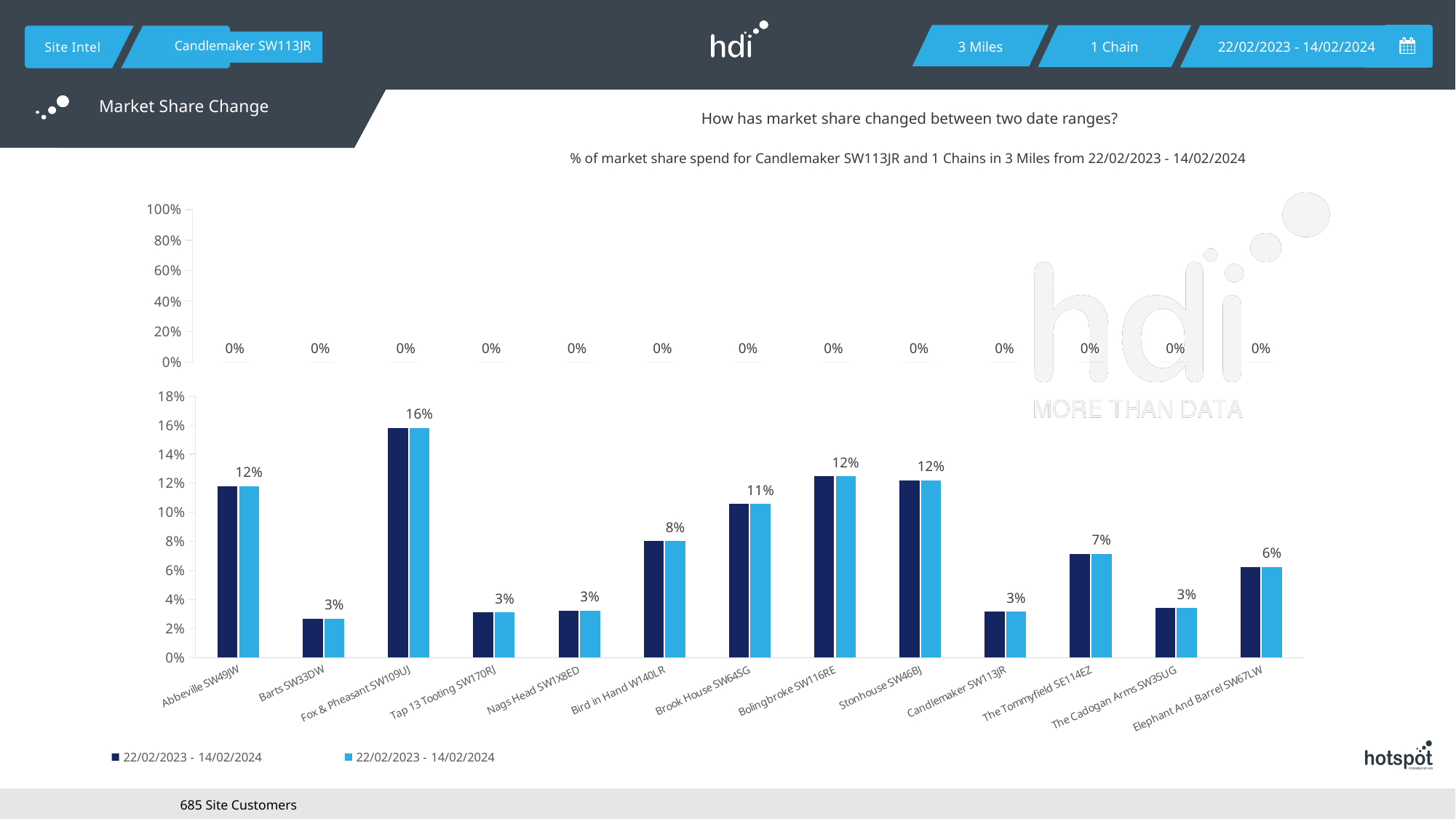
In the bottom chart, is the value for Abbeville SW49JW greater or less than 10%? greater In the bottom chart, what is the difference between the market share of Fox & Pheasant SW109UJ and Bird in Hand W140LR? 8% In the bottom chart, what is the market share value shown for The Tommyfield SE114EZ? 7% In the bottom chart, which has a larger market share, Brook House SW64SG or Bird in Hand W140LR? Brook House SW64SG How many series does the legend of the bottom chart list? 2 How many venues are shown on the x axis of the bottom chart? 13 What kind of chart is the bottom chart? Bar chart In the bottom chart, what is the market share value shown for Brook House SW64SG? 11% What is the subtitle text shown above the charts describing the data? % of market share spend for Candlemaker SW113JR and 1 Chains in 3 Miles from 22/02/2023 - 14/02/2024 In the bottom chart, what is the market share value shown for Fox & Pheasant SW109UJ? 16% In the bottom chart, which venue has the highest market share? Fox & Pheasant SW109UJ In the top chart, what value is shown for Bolingbroke SW116RE? 0%